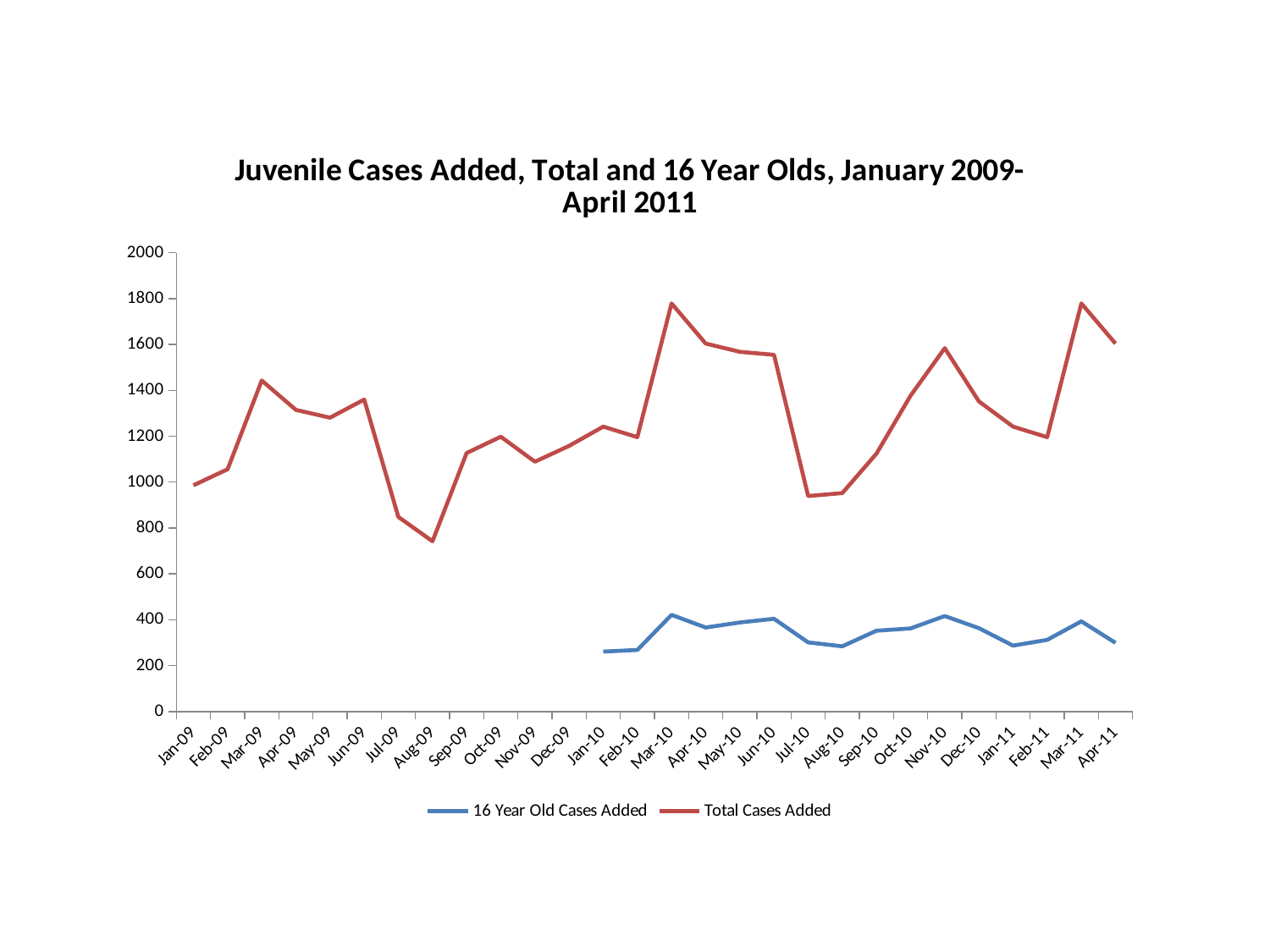
How many series does the legend list? 2 Which month has the lowest value for Total Cases Added? Aug-09 What kind of chart is shown on the slide? Line chart Is the value for Total Cases Added in Aug-09 greater or less than 800? less Is the value for 16 Year Old Cases Added in Jan-10 greater or less than 400? less How many months are shown on the x axis? 28 Do the values for Total Cases Added rise or fall from Jun-09 to Aug-09? Fall Is the value for Total Cases Added in Mar-10 greater or less than 1600? greater In which month does the 16 Year Old Cases Added line begin? Jan-10 Do the values for 16 Year Old Cases Added rise or fall from Nov-10 to Jan-11? Fall Which is larger for Total Cases Added: Feb-10 or Mar-10? Mar-10